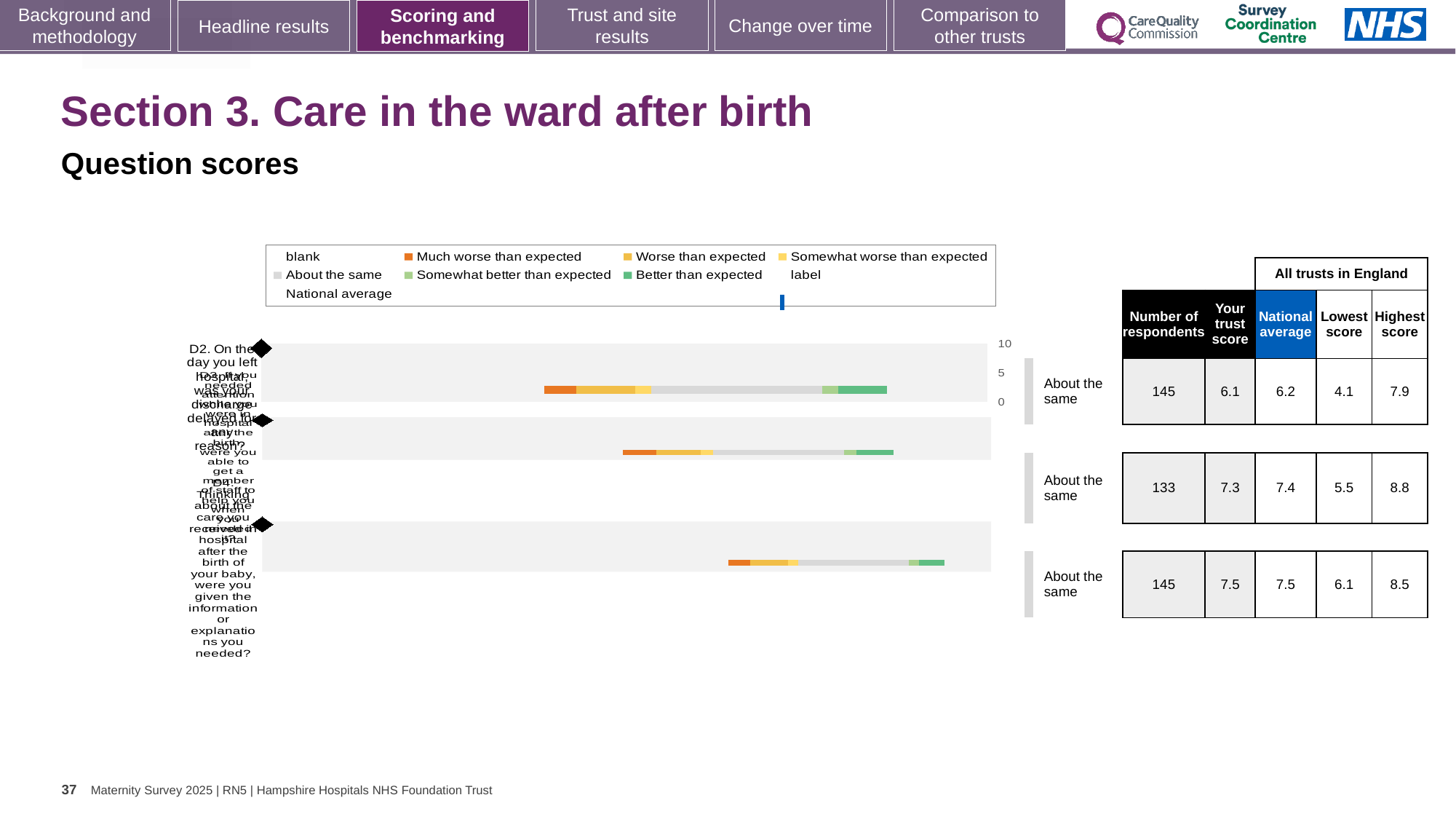
In the table beside the chart, which row has the highest 'Your trust score'? the third row (7.5) How many horizontal bars are plotted in the chart? 3 In the table beside the chart, what is 'Your trust score' in the second row? 7.3 What colour is used for the 'Better than expected' legend entry? green What colour is used for the 'Much worse than expected' legend entry? orange In the table beside the chart, what is the highest score in the second row? 8.8 What kind of chart is shown on the slide? bar chart In the table beside the chart, in the second row, which is larger: 'Your trust score' or the national average? National average In the table beside the chart, what is the national average in the third row? 7.5 In the table beside the chart, what is the difference between the national average and 'Your trust score' in the first row? 0.1 In the table beside the chart, what is the lowest score in the first row? 4.1 In the table beside the chart, what is the number of respondents in the first row? 145